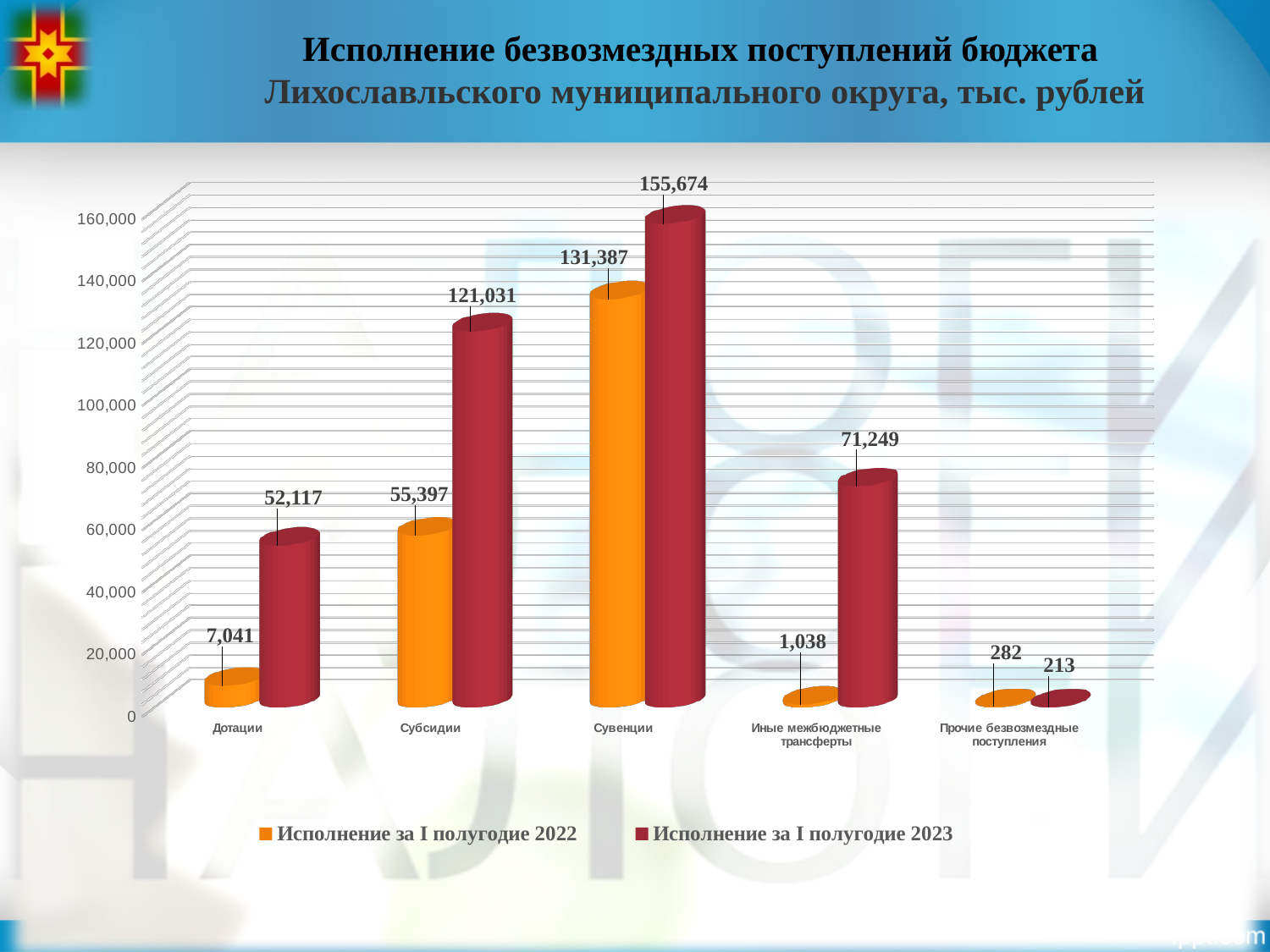
What is the value for Дотации in the series Исполнение за I полугодие 2022? 7,041 Is the value for Субсидии in the series Исполнение за I полугодие 2023 greater or less than 100,000? greater What is the value for Иные межбюджетные трансферты in the series Исполнение за I полугодие 2023? 71,249 For Прочие безвозмездные поступления, which series has the larger value: Исполнение за I полугодие 2022 or Исполнение за I полугодие 2023? Исполнение за I полугодие 2022 What is the difference between the 2023 and 2022 values for Субвенции? 24,287 What is the value for Субвенции in the series Исполнение за I полугодие 2023? 155,674 How many categories are shown on the x axis? 5 How many series does the legend list? 2 What kind of chart is shown on the slide? Bar chart Which category has the highest value in the series Исполнение за I полугодие 2022? Субвенции Which category has the lowest value in the series Исполнение за I полугодие 2023? Прочие безвозмездные поступления What is the difference between the 2023 and 2022 values for Субсидии? 65,634